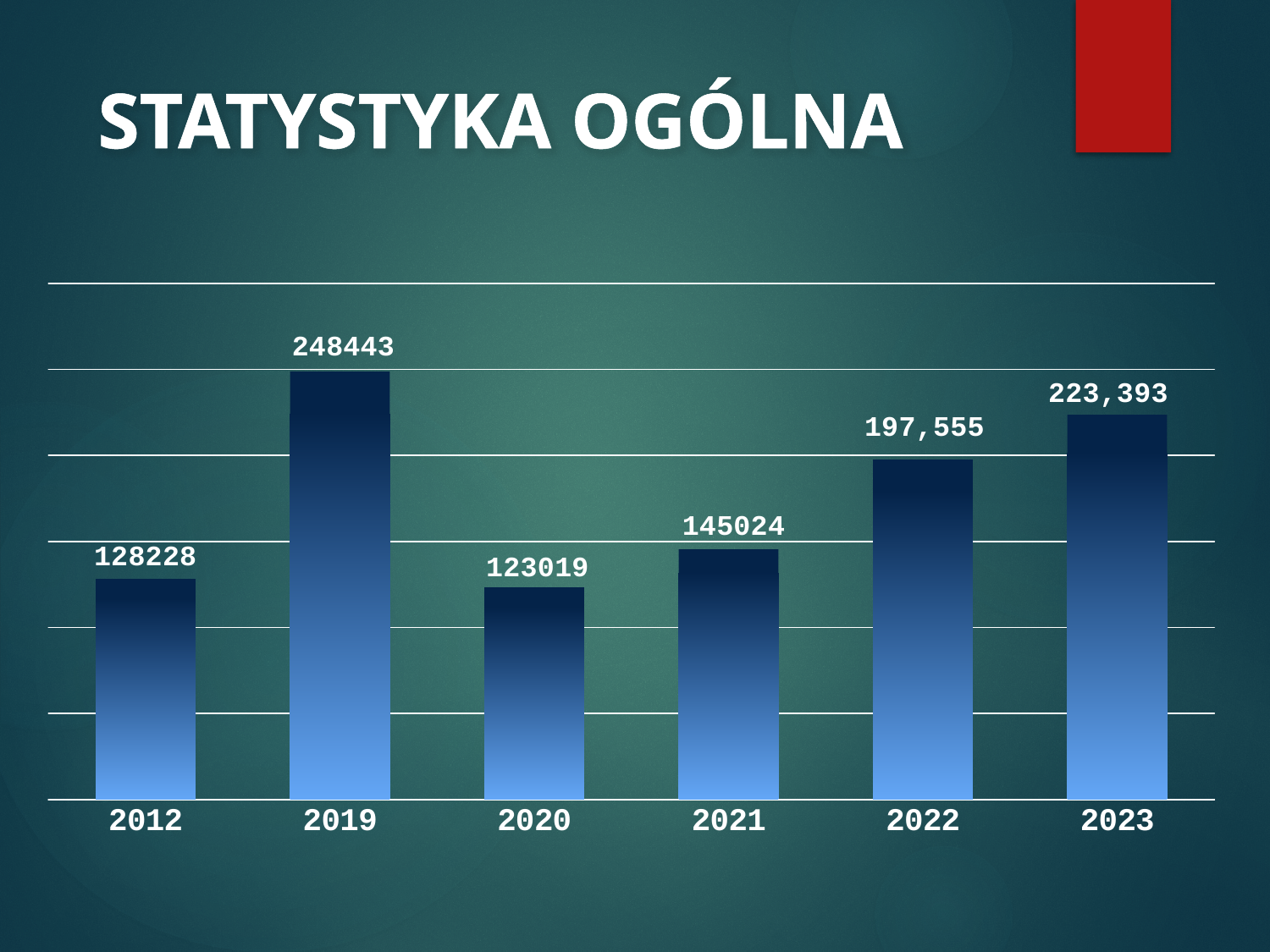
From 2020 to 2023, do the values rise or fall? rise Which year has the lowest value? 2020 Which year has the highest value? 2019 What kind of chart is shown on the slide? bar chart What is the difference between the values for 2022 and 2021? 52531 Which is larger, the value for 2021 or the value for 2012? 2021 What is the value for 2012? 128228 What is the difference between the values for 2019 and 2023? 25050 What is the value for 2022? 197,555 How many years are shown on the x axis? 6 What is the value for 2023? 223,393 What is the value for 2019? 248443